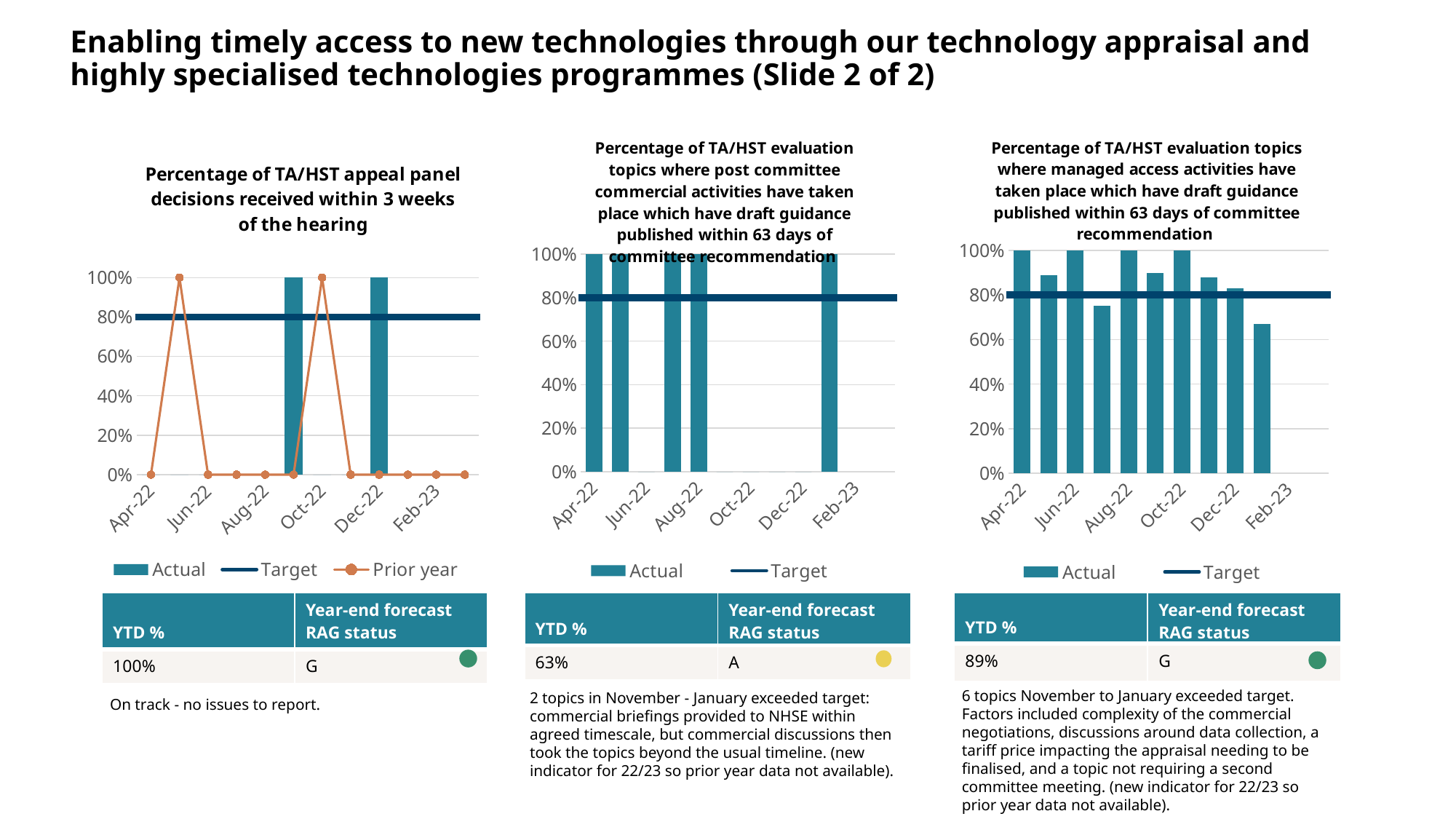
In the right chart (managed access activities), is the lowest bar greater or less than 80%? less In the middle chart (post committee commercial activities), what value does the Target line sit at? 80% In the middle chart (post committee commercial activities), what is the Actual value at Apr-22? 100% In the left chart (appeal panel decisions), what is the difference between the Prior year value at Oct-22 and at Apr-22? 100% How many series does the legend of the left chart (appeal panel decisions) list? 3 In the middle chart (post committee commercial activities), what kind of chart is used to show the Actual values? bar chart In the left chart (appeal panel decisions), what is the Prior year value at Apr-22? 0% In the left chart (appeal panel decisions), what colour is the Prior year line? orange In the left chart (appeal panel decisions), what is the Actual value at Dec-22? 100% In the left chart (appeal panel decisions), what is the Prior year value at Oct-22? 100% How many series does the legend of the right chart (managed access activities) list? 2